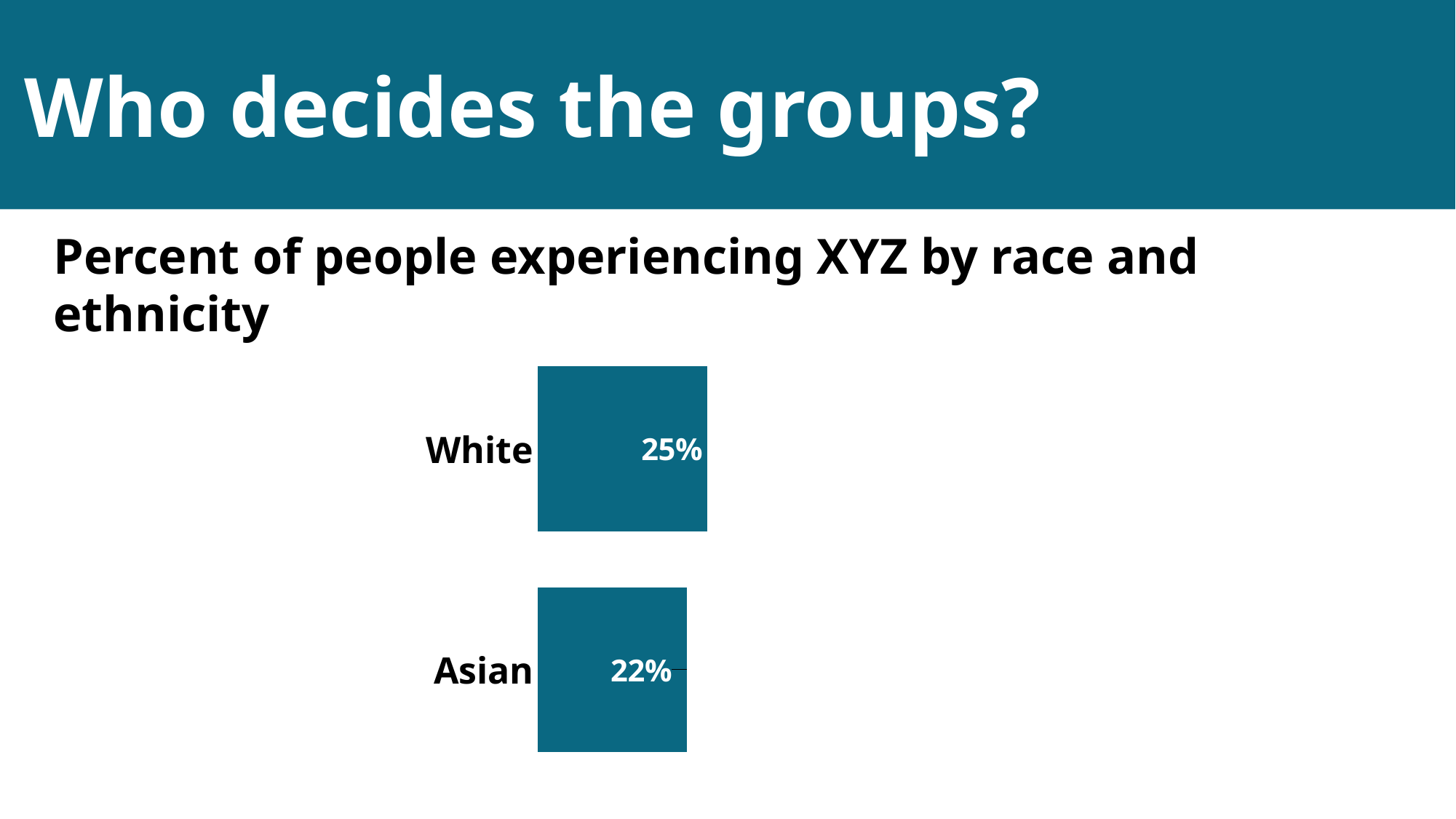
Which category has the lowest value? Asian What is the value for Asian? 22% Are the bars in the chart horizontal or vertical? Horizontal What is the difference between the values for White and Asian? 3% What is the value for White? 25% Which is larger, the value for White or the value for Asian? White Which category has the highest value? White How many categories are shown in the chart? 2 What kind of chart is shown on the slide? Bar chart What is the title of the chart? Percent of people experiencing XYZ by race and ethnicity